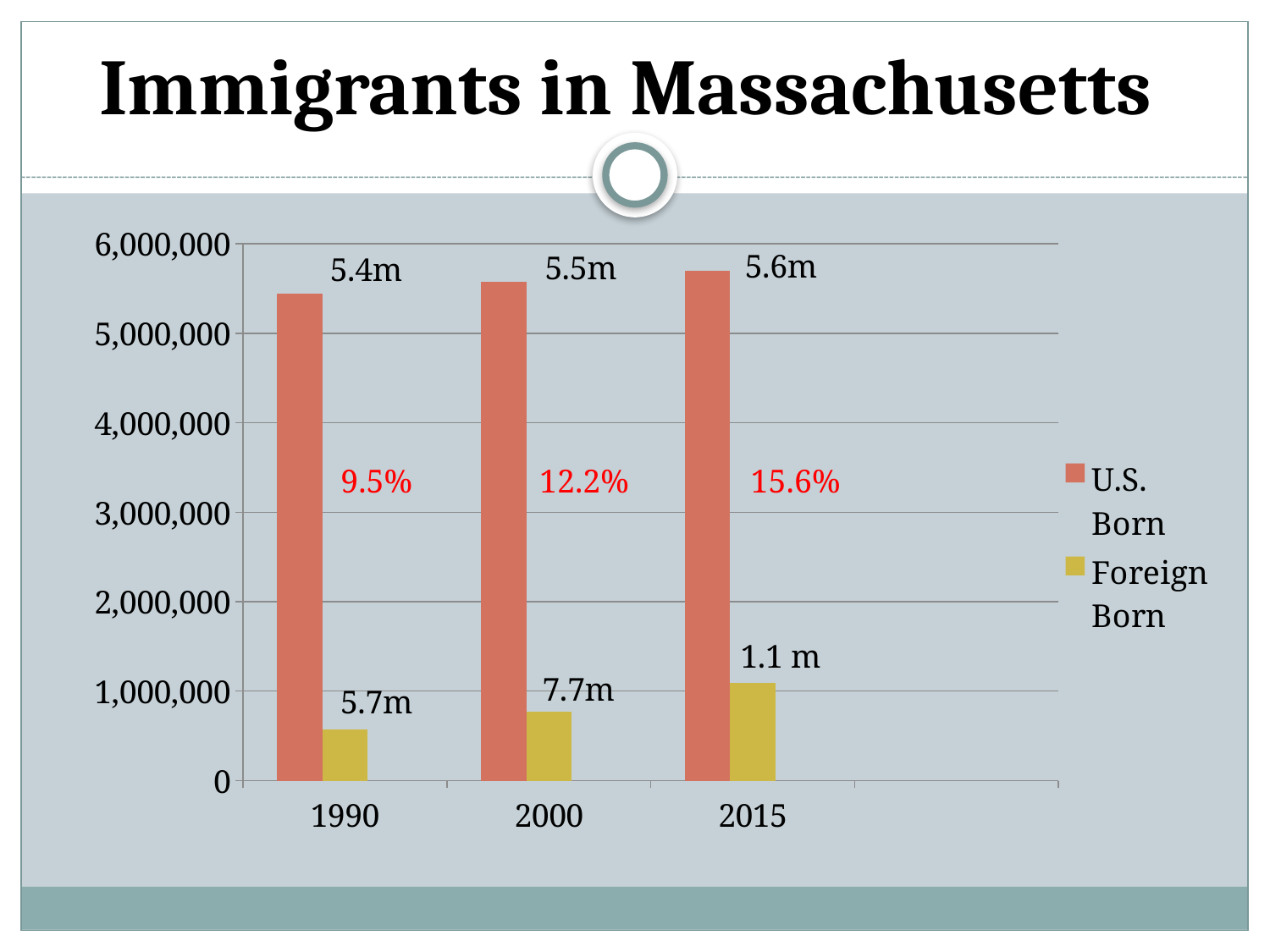
Do the Foreign Born bars rise or fall from 1990 to 2015? rise What is the labelled value for U.S. Born in 2015? 5.6m How many series does the legend list? 2 Is the U.S. Born value for 2000 greater or less than 5,000,000? greater What is the labelled value for Foreign Born in 2015? 1.1 m Is the Foreign Born value for 1990 greater or less than 1,000,000? less What kind of chart is shown on the slide? bar chart What is the labelled value for U.S. Born in 1990? 5.4m What red percentage is printed above the 2000 bars? 12.2% What red percentage is printed above the 2015 bars? 15.6% How many years are shown on the x axis? 3 In which year is the Foreign Born bar the tallest? 2015